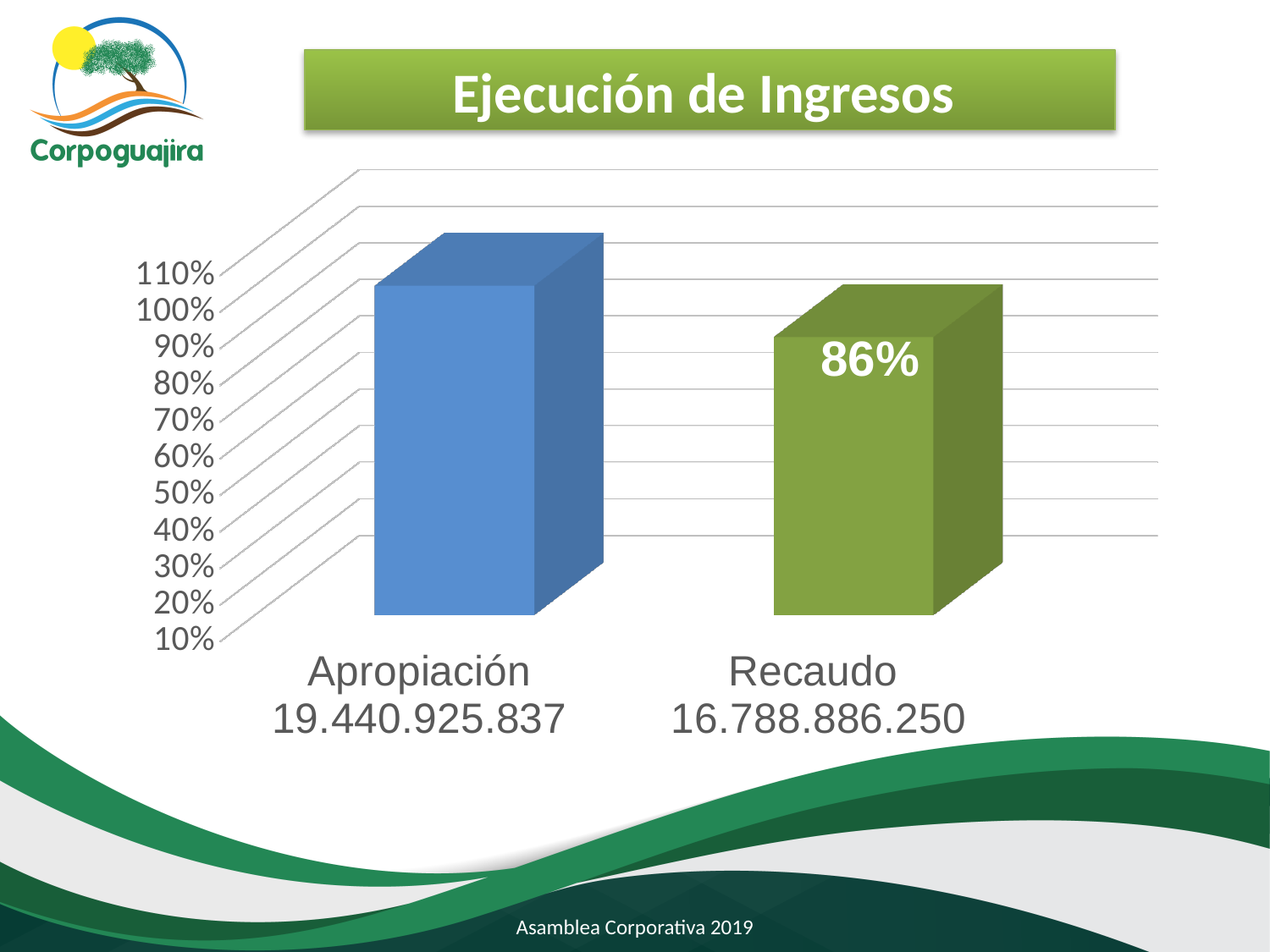
What amount is printed under the Apropiación label? 19.440.925.837 How many bars are plotted in the chart? 2 Which category has the taller bar? Apropiación What kind of chart is shown on the slide? bar chart Is the value for Apropiación greater or less than 80%? greater What is the title of the chart? Ejecución de Ingresos Is the value for Recaudo greater or less than 90%? less What amount is printed under the Recaudo label? 16.788.886.250 Which category has the shorter bar? Recaudo What colour is the Recaudo bar? green What percentage is labelled on the Recaudo bar? 86% Is the bar for Apropiación taller or shorter than the bar for Recaudo? taller